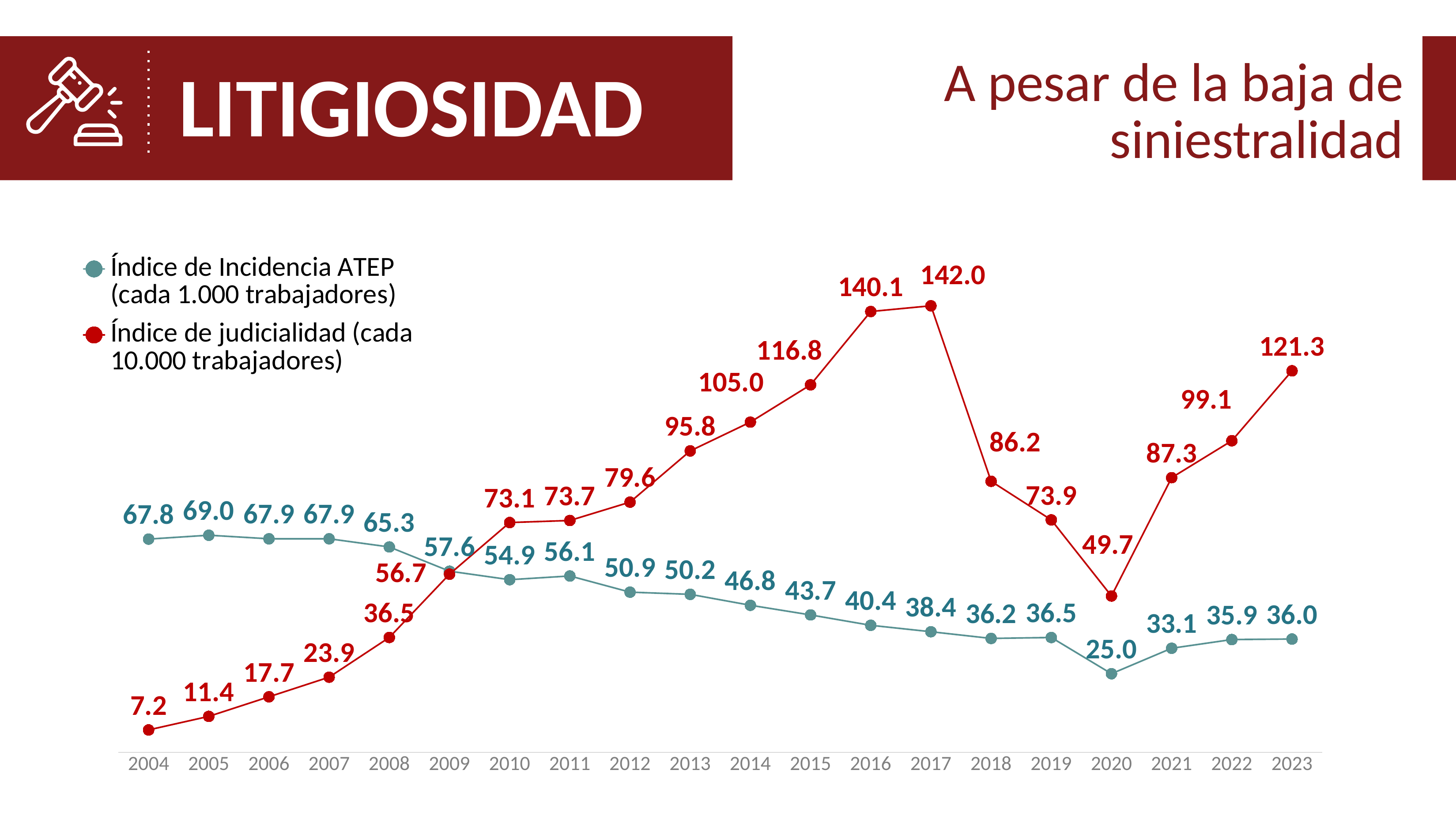
In which year is the Índice de Incidencia ATEP at its lowest? 2020 In which year does the Índice de judicialidad reach its highest value? 2017 What is the difference between the Índice de judicialidad and the Índice de Incidencia ATEP in 2023? 85.3 In which year is the Índice de Incidencia ATEP at its highest? 2005 Which is larger in 2008: the Índice de Incidencia ATEP or the Índice de judicialidad? Índice de Incidencia ATEP What is the value of the Índice de judicialidad in 2004? 7.2 By how much did the Índice de Incidencia ATEP fall from 2004 to 2023? 31.8 What is the value of the Índice de Incidencia ATEP in 2020? 25.0 How many years are shown on the x axis? 20 How many series does the legend list? 2 What kind of chart is shown on the slide? Line chart What is the value of the Índice de judicialidad in 2017? 142.0